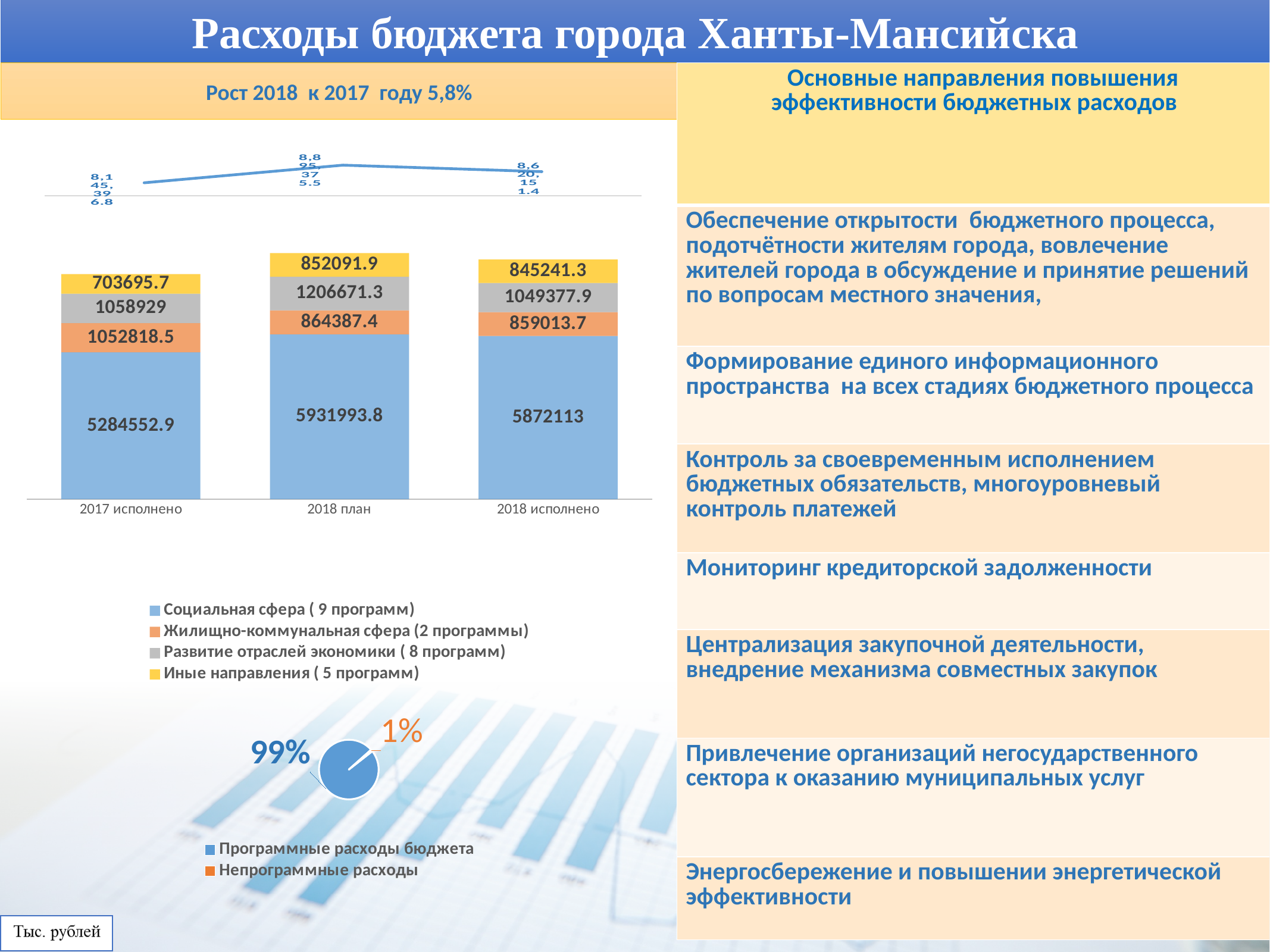
How many categories are shown on the x axis of the stacked bar chart? 3 In the stacked bar chart, what is the value for Жилищно-коммунальная сфера in 2018 исполнено? 859013.7 In the pie chart at the bottom, what share is Программные расходы бюджета? 99% In the stacked bar chart, what is the value for Социальная сфера in 2017 исполнено? 5284552.9 In the stacked bar chart, what is the total of the 2017 исполнено bar? 8099996.1 In the stacked bar chart, which is larger: Жилищно-коммунальная сфера in 2017 исполнено or in 2018 план? 2017 исполнено In the stacked bar chart, which category has the lowest value for Иные направления? 2017 исполнено In the stacked bar chart, which category has the highest value for Социальная сфера? 2018 план How many series does the legend of the stacked bar chart list? 4 In the stacked bar chart, what is the value for Развитие отраслей экономики in 2018 план? 1206671.3 In the stacked bar chart, what is the difference between the Социальная сфера values for 2018 план and 2018 исполнено? 59880.8 In the stacked bar chart, what is the value for Иные направления in 2018 исполнено? 845241.3